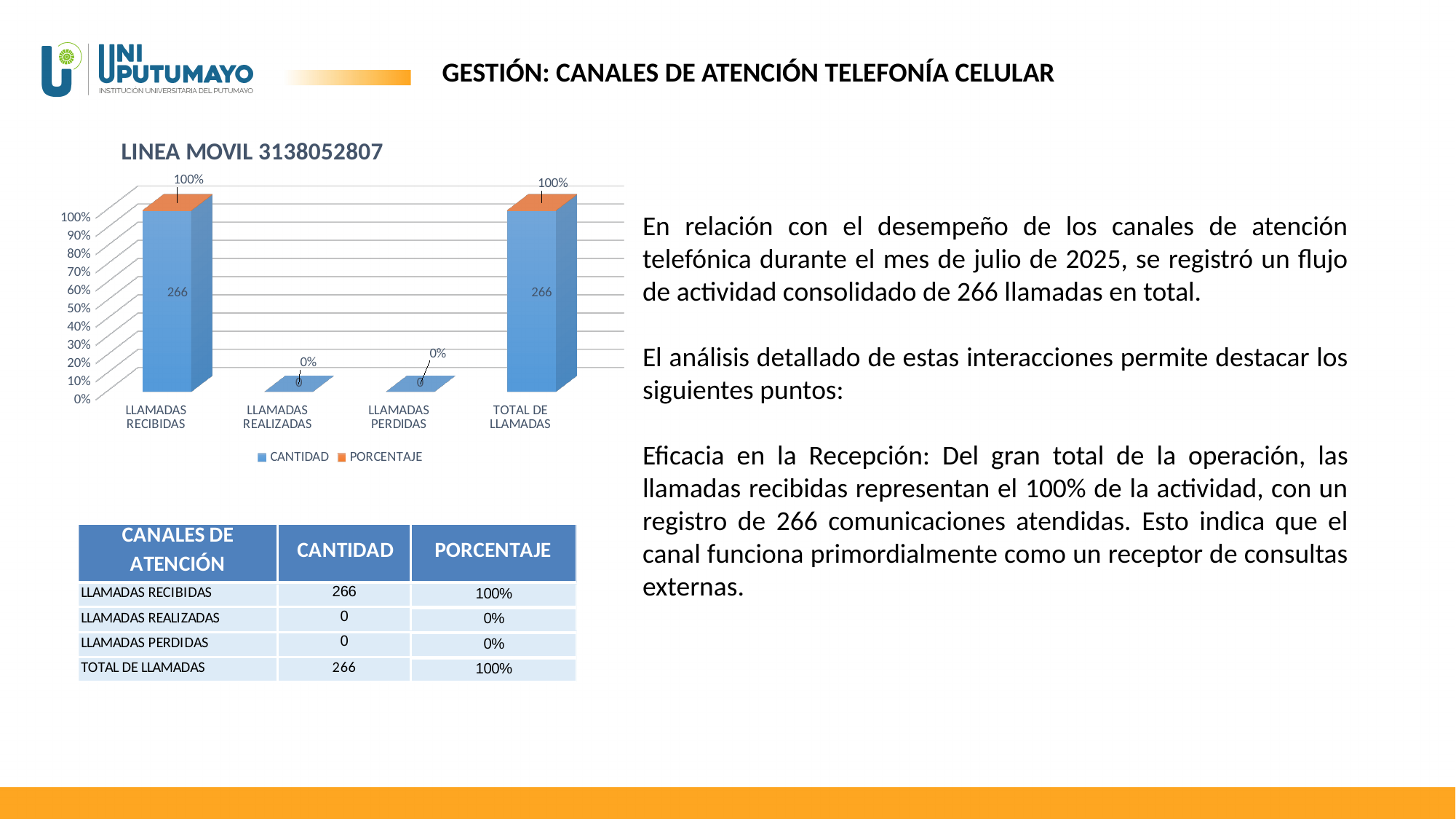
What is the PORCENTAJE value for LLAMADAS PERDIDAS? 0% How many series does the chart legend list? 2 What are the two series named in the chart legend? CANTIDAD and PORCENTAJE Which category has the lowest CANTIDAD value, LLAMADAS RECIBIDAS or LLAMADAS PERDIDAS? LLAMADAS PERDIDAS What is the PORCENTAJE value for LLAMADAS RECIBIDAS? 100% What is the CANTIDAD value for LLAMADAS RECIBIDAS? 266 What type of chart is shown on the slide? bar chart What is the difference between the CANTIDAD values for LLAMADAS RECIBIDAS and LLAMADAS REALIZADAS? 266 How many categories are shown on the x axis of the chart? 4 What is the title of the chart? LINEA MOVIL 3138052807 What is the CANTIDAD value for LLAMADAS REALIZADAS? 0 What is the CANTIDAD value for TOTAL DE LLAMADAS? 266